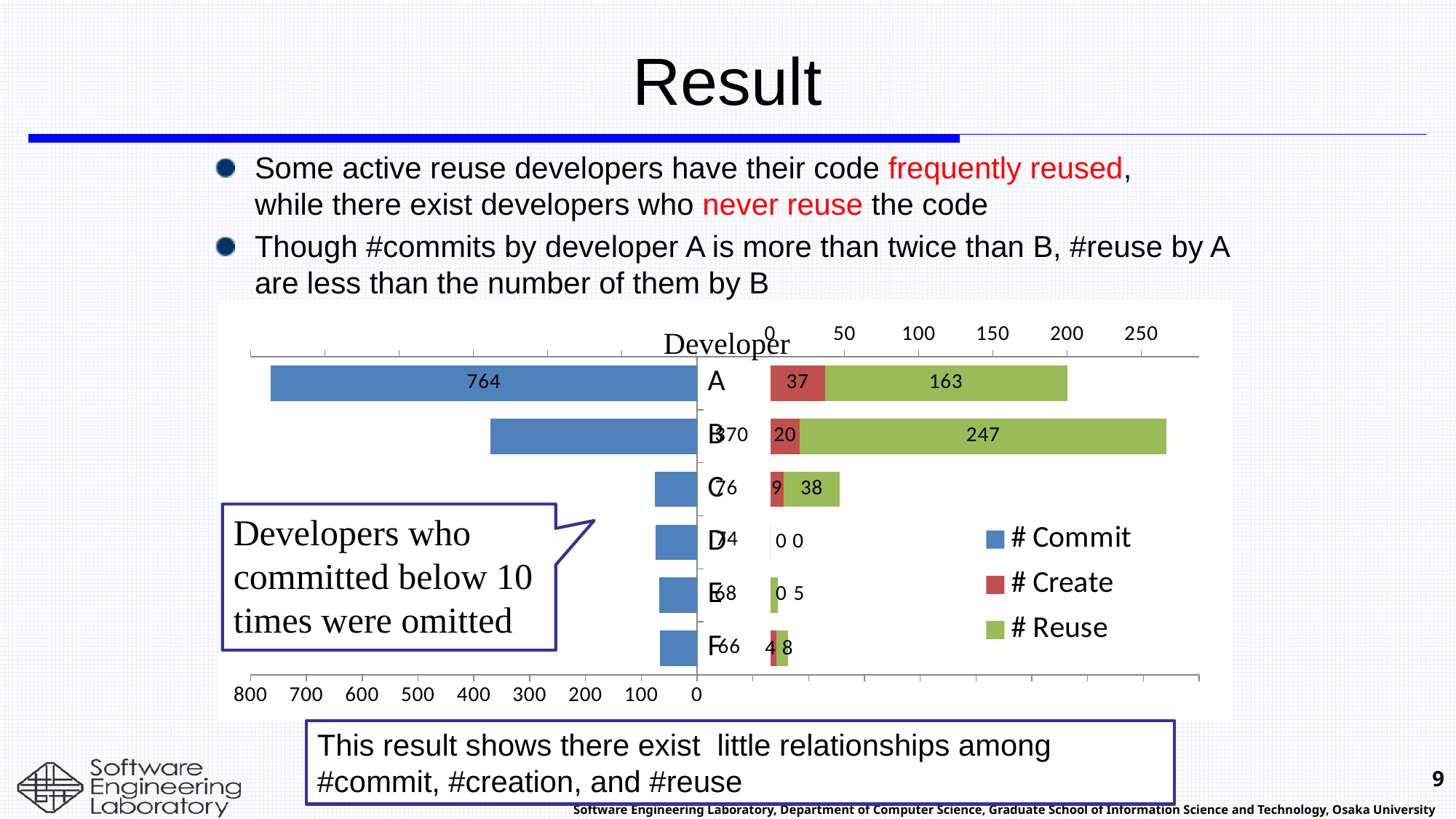
What is the # Reuse value for developer C? 38 How many developers are shown in the chart? 6 Which developer has the lowest # Reuse value? D How many series does the legend list? 3 What is the # Reuse value for developer B? 247 What is the # Commit value for developer A? 764 Which developer has the highest # Reuse value? B Which developer has the larger # Reuse value, A or B? B What is the difference between the # Commit values of developer A and developer B? 394 Which developer has the highest # Commit value? A What is the # Create value for developer A? 37 What is the combined total of # Create and # Reuse for developer A? 200